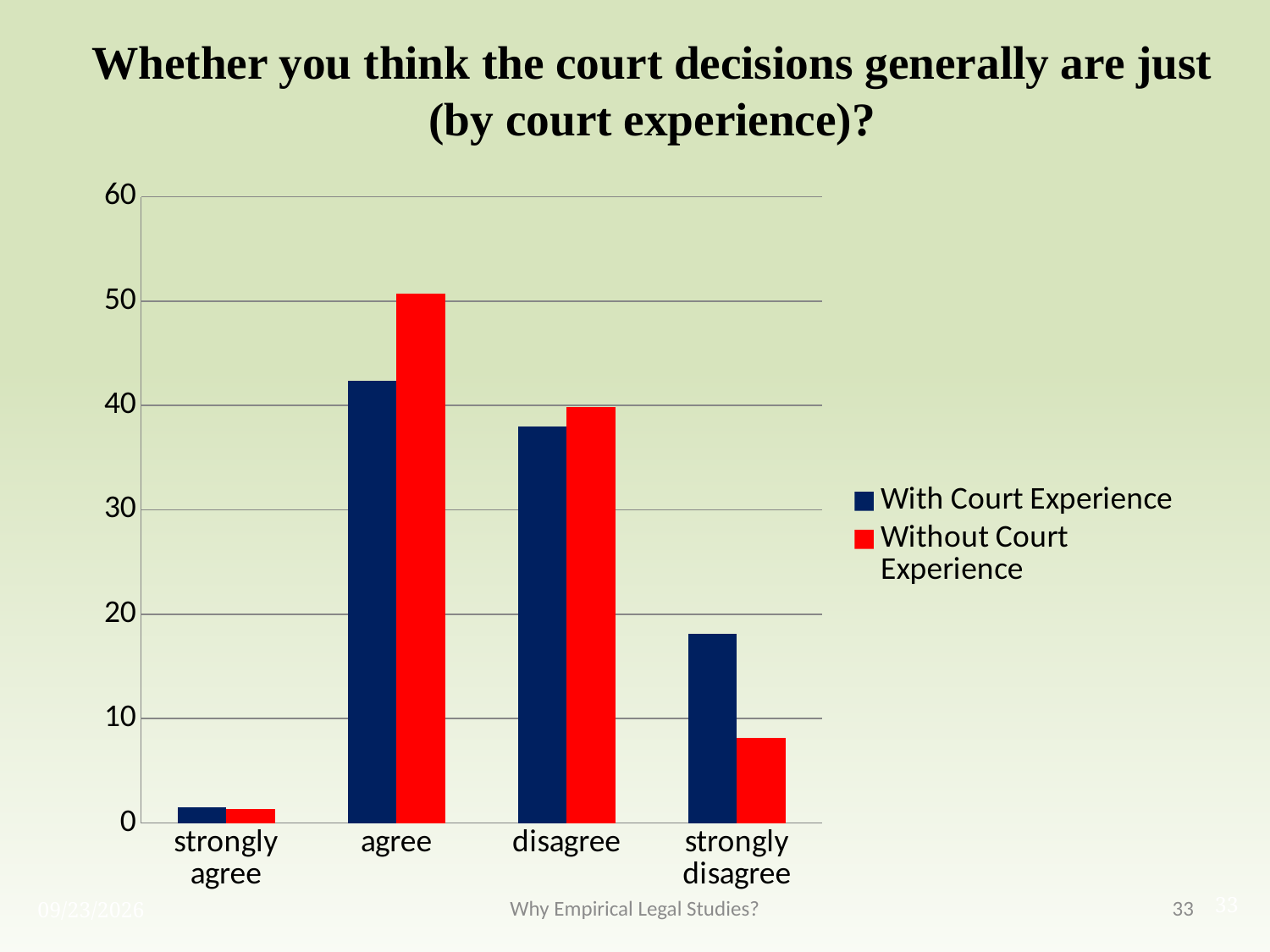
What kind of chart is shown on the slide? bar chart How many response categories are shown on the x axis? 4 Which colour represents the Without Court Experience series? red For the agree category, which series has the larger value, With Court Experience or Without Court Experience? Without Court Experience Which category has the highest value for Without Court Experience? agree Is the value for Without Court Experience in the strongly disagree category greater or less than 10? less Is the value for With Court Experience in the agree category greater or less than 50? less Is the value for With Court Experience in the strongly disagree category greater or less than 10? greater Which category has the lowest value for With Court Experience? strongly agree How many series does the legend list? 2 Which category has the highest value for With Court Experience? agree For the strongly disagree category, which series has the larger value, With Court Experience or Without Court Experience? With Court Experience